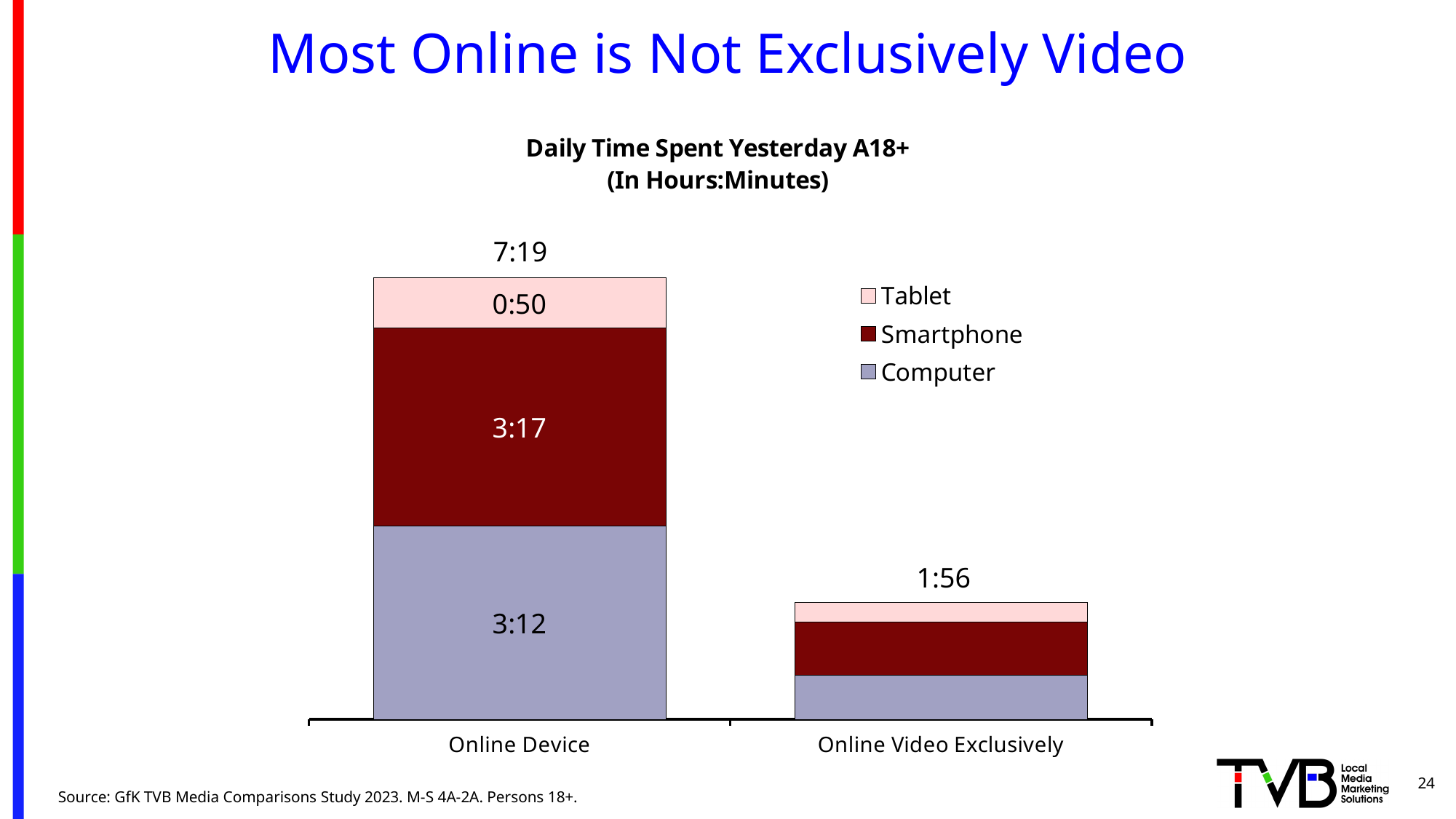
What kind of chart is shown on the slide? Stacked bar chart What is the total daily time spent for Online Device? 7:19 In the Online Device bar, which is larger, the Smartphone segment or the Computer segment? Smartphone Which category has the higher total time, Online Device or Online Video Exclusively? Online Device What is the title of the chart? Daily Time Spent Yesterday A18+ (In Hours:Minutes) What is the difference between the Online Device total and the Online Video Exclusively total? 5:23 How much time is spent on Smartphone in the Online Device bar? 3:17 How many series does the legend list? 3 How many categories are shown on the x axis? 2 How much time is spent on Computer in the Online Device bar? 3:12 How much time is spent on Tablet in the Online Device bar? 0:50 What is the total daily time spent for Online Video Exclusively? 1:56